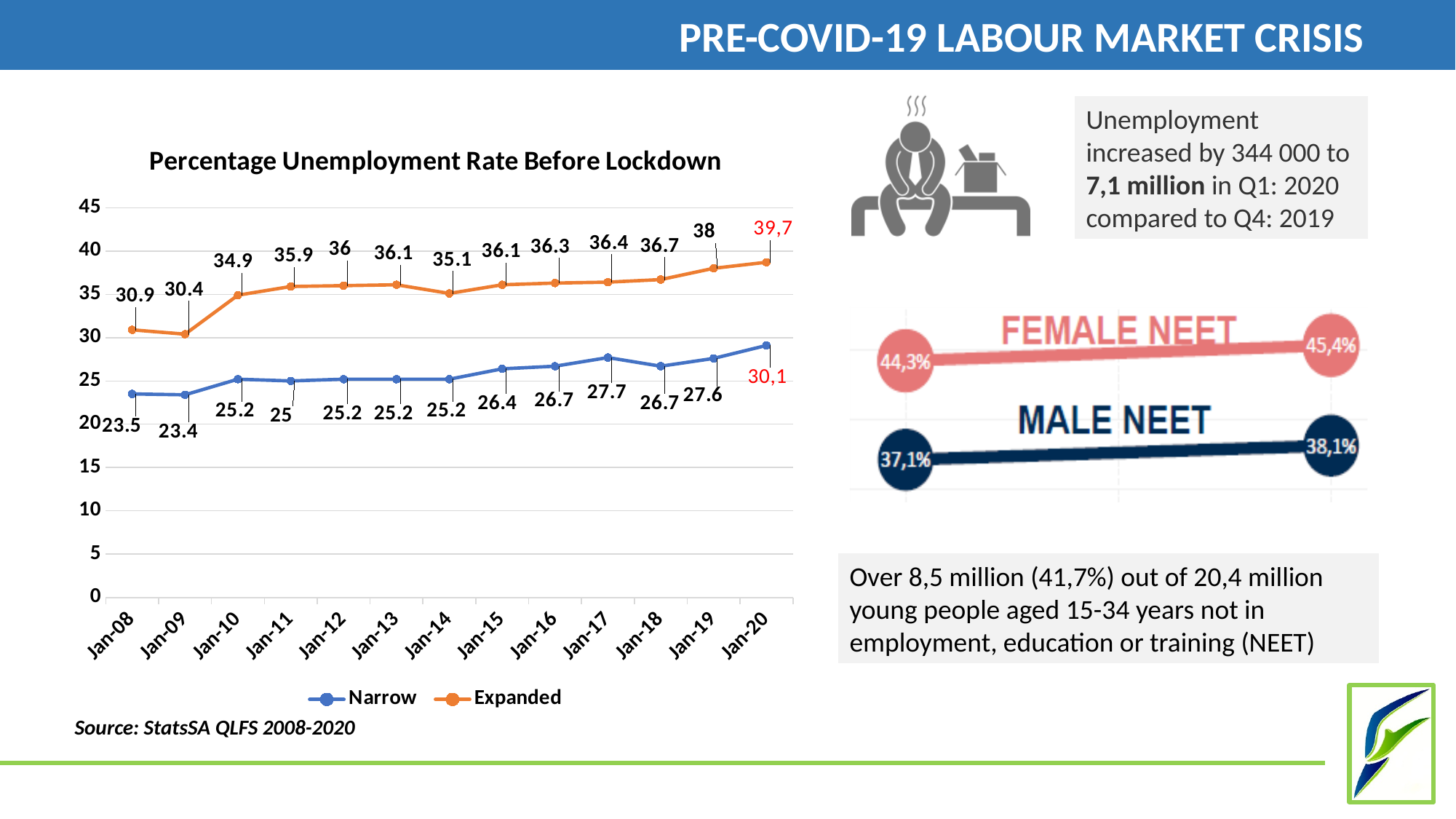
In the 'Percentage Unemployment Rate Before Lockdown' chart, is the Narrow rate higher at Jan-18 or Jan-19? Jan-19 In the 'Percentage Unemployment Rate Before Lockdown' chart, what is the Expanded unemployment rate at Jan-14? 35.1 In the 'Percentage Unemployment Rate Before Lockdown' chart, at which date is the Narrow rate lowest? Jan-09 In the 'Percentage Unemployment Rate Before Lockdown' chart, which colour is used for the Expanded series? Orange What type of chart is 'Percentage Unemployment Rate Before Lockdown'? Line chart In the 'Percentage Unemployment Rate Before Lockdown' chart, what is the difference between the Expanded and Narrow rates at Jan-20? 9,6 In the 'Percentage Unemployment Rate Before Lockdown' chart, at which date is the Expanded rate highest? Jan-20 In the 'Percentage Unemployment Rate Before Lockdown' chart, what is the Narrow unemployment rate at Jan-17? 27.7 In the 'Percentage Unemployment Rate Before Lockdown' chart, does the Expanded rate generally rise or fall from Jan-08 to Jan-20? Rise How many series does the legend of the 'Percentage Unemployment Rate Before Lockdown' chart list? 2 In the 'Percentage Unemployment Rate Before Lockdown' chart, is the Expanded rate at Jan-20 greater or less than 35? greater How many dates are plotted on the x axis of the 'Percentage Unemployment Rate Before Lockdown' chart? 13